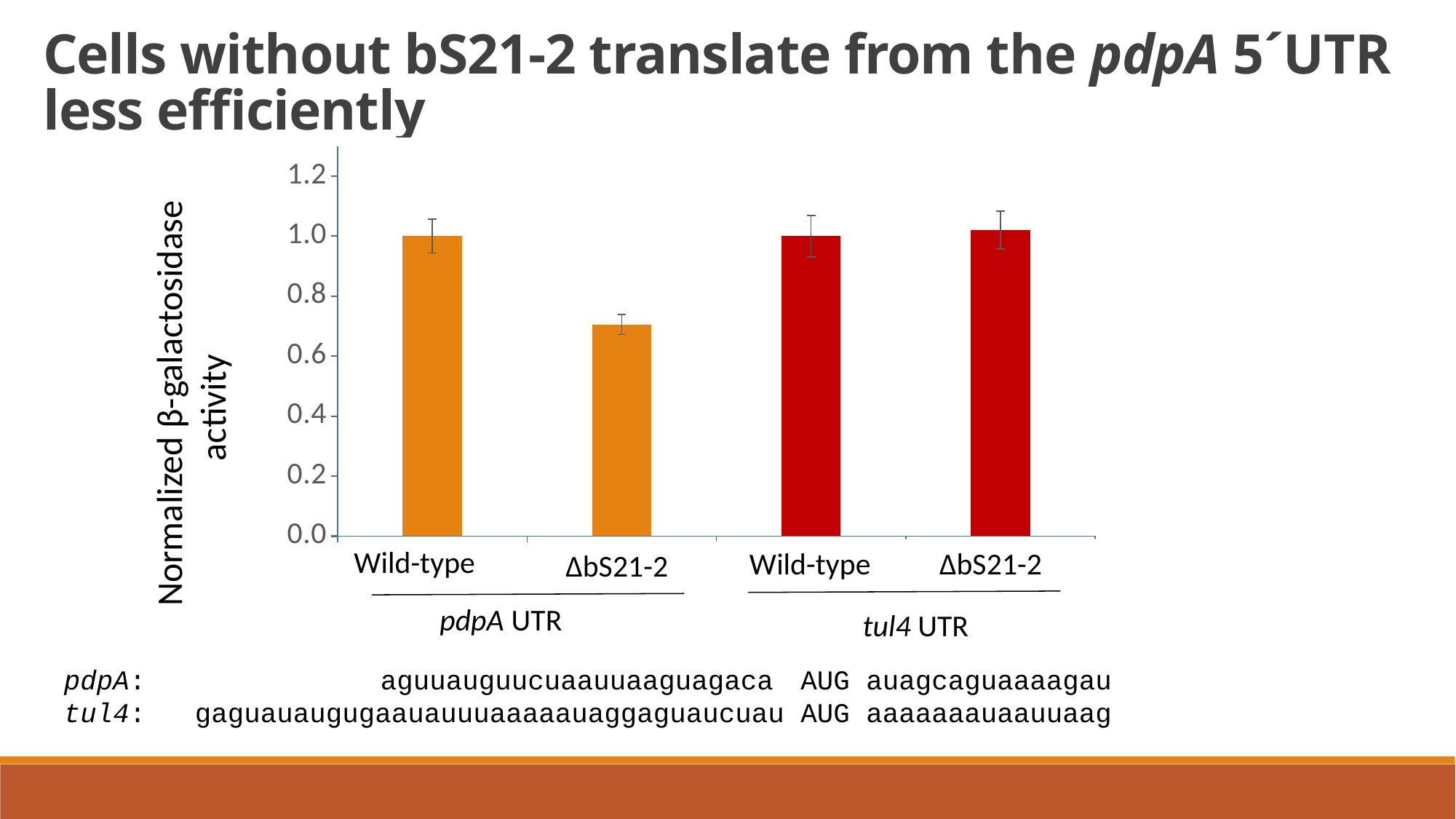
Under the pdpA UTR, which has the higher normalized β-galactosidase activity, Wild-type or ΔbS21-2? Wild-type What colour are the bars for the tul4 UTR group? red How many bars are plotted in the chart? 4 What kind of chart is shown on the slide? bar chart What is the normalized β-galactosidase activity for Wild-type under the pdpA UTR? 1.0 Is the value for ΔbS21-2 under the pdpA UTR greater or less than 0.8? less How many UTR groups are labelled beneath the x axis? 2 What is the label on the y axis of the chart? Normalized β-galactosidase activity Is the value for ΔbS21-2 under the tul4 UTR greater or less than 0.8? greater Is the value for ΔbS21-2 under the pdpA UTR greater or less than 0.6? greater Within the pdpA UTR group, does the activity rise or fall from Wild-type to ΔbS21-2? fall Which bar has the lowest normalized β-galactosidase activity? ΔbS21-2 (pdpA UTR)